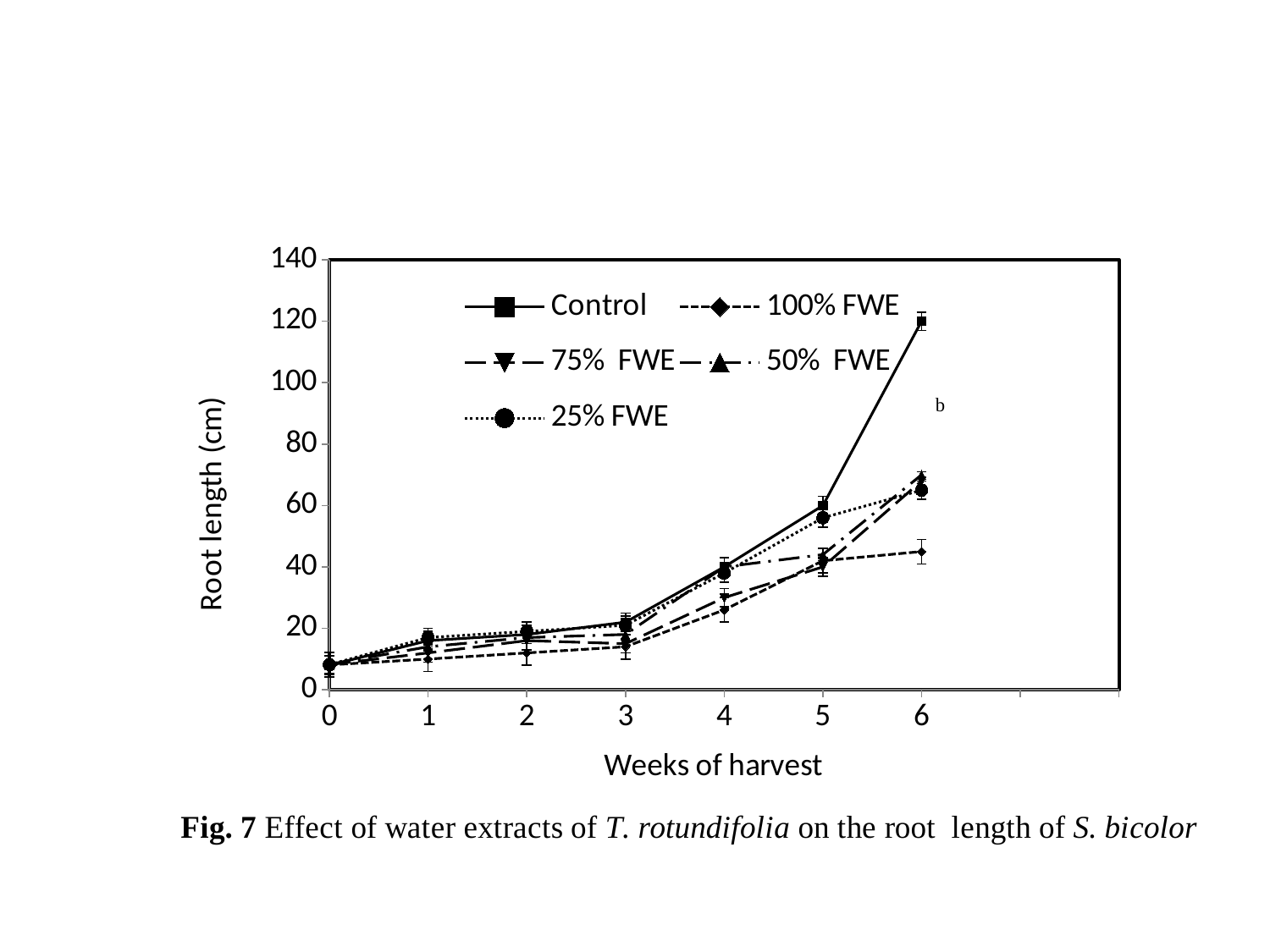
How many series does the legend list? 5 How many week points are plotted along the x axis? 7 Which series has the lowest root length at week 6? 100% FWE Which series has the highest root length at week 6? Control Is the root length for Control at week 6 greater or less than 100? greater Is the root length for 100% FWE at week 6 greater or less than 60? less Is the root length for 50% FWE at week 6 greater or less than 60? greater What is the label of the y axis? Root length (cm) At week 6, which has the larger root length, Control or 100% FWE? Control What kind of chart is shown on the slide? line chart Does the root length for Control rise or fall from week 0 to week 6? rise